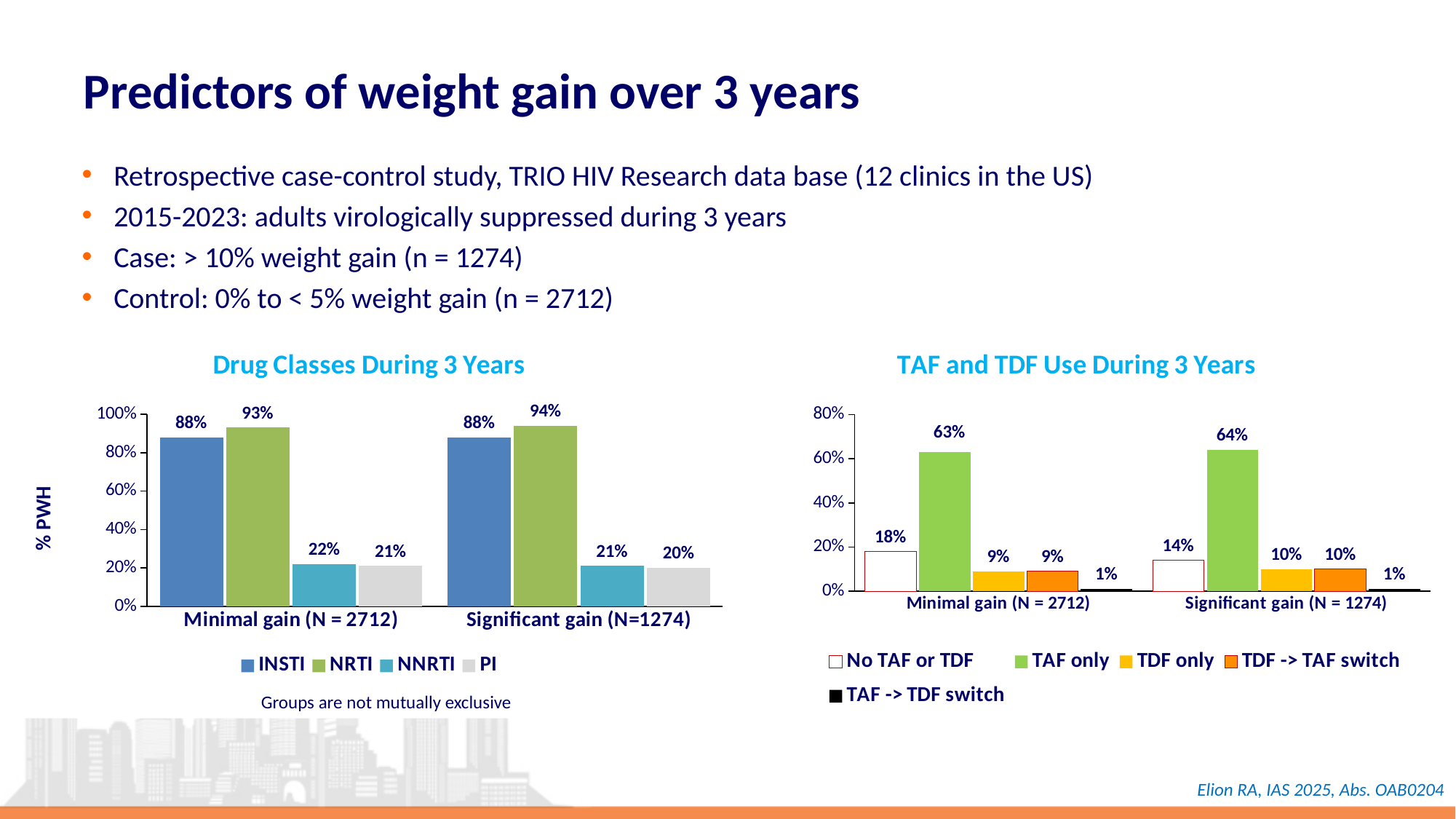
In the 'TAF and TDF Use During 3 Years' chart, what is the difference between No TAF or TDF in the Minimal gain group and in the Significant gain group? 4% In the 'TAF and TDF Use During 3 Years' chart, which series has the highest value in the Minimal gain (N = 2712) group? TAF only In the 'TAF and TDF Use During 3 Years' chart, what is the value for No TAF or TDF in the Minimal gain (N = 2712) group? 18% In the 'TAF and TDF Use During 3 Years' chart, which is larger for No TAF or TDF: Minimal gain or Significant gain? Minimal gain In the 'TAF and TDF Use During 3 Years' chart, how many series does the legend list? 5 In the 'Drug Classes During 3 Years' chart, what is the value for NRTI in the Significant gain (N=1274) group? 94% In the 'TAF and TDF Use During 3 Years' chart, what is the value for TAF only in the Significant gain (N = 1274) group? 64% In the 'Drug Classes During 3 Years' chart, what is the difference between NRTI and INSTI in the Minimal gain (N = 2712) group? 5% What kind of chart is the 'Drug Classes During 3 Years' chart? Bar chart In the 'Drug Classes During 3 Years' chart, how many series does the legend list? 4 In the 'Drug Classes During 3 Years' chart, what is the value for INSTI in the Minimal gain (N = 2712) group? 88% In the 'Drug Classes During 3 Years' chart, which drug class has the lowest value in the Significant gain (N=1274) group? PI